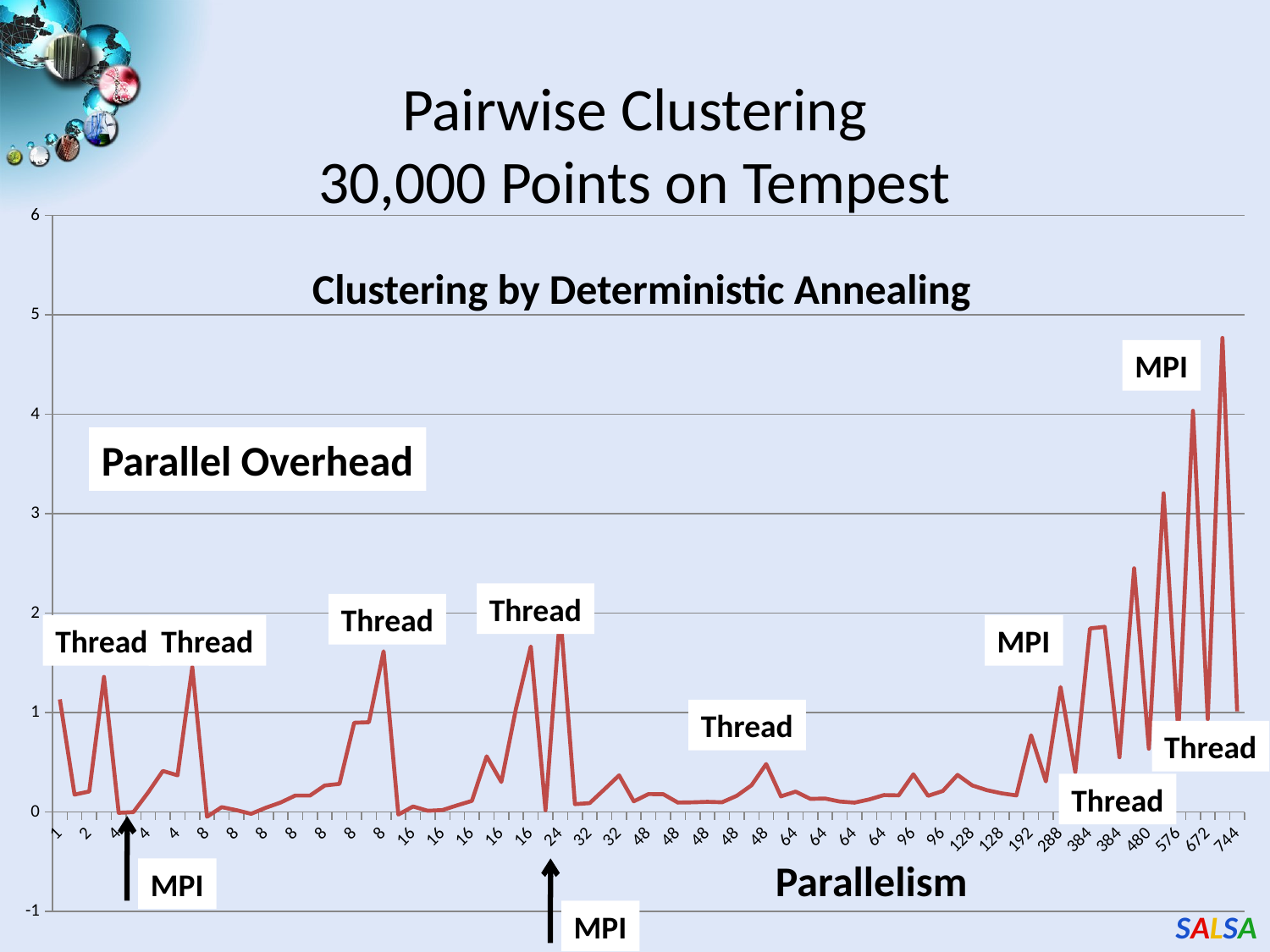
What is the title printed inside the chart area? Clustering by Deterministic Annealing What kind of chart is shown on the slide? line chart Do the peaks of the line generally rise or fall as parallelism increases toward the right end of the x axis? rise Is the value at parallelism 128 greater or less than 1? less Which has the larger value, parallelism 744 or parallelism 672? 744 What label is given to the x axis of the chart? Parallelism At which parallelism value on the x axis does the line reach its highest point? 744